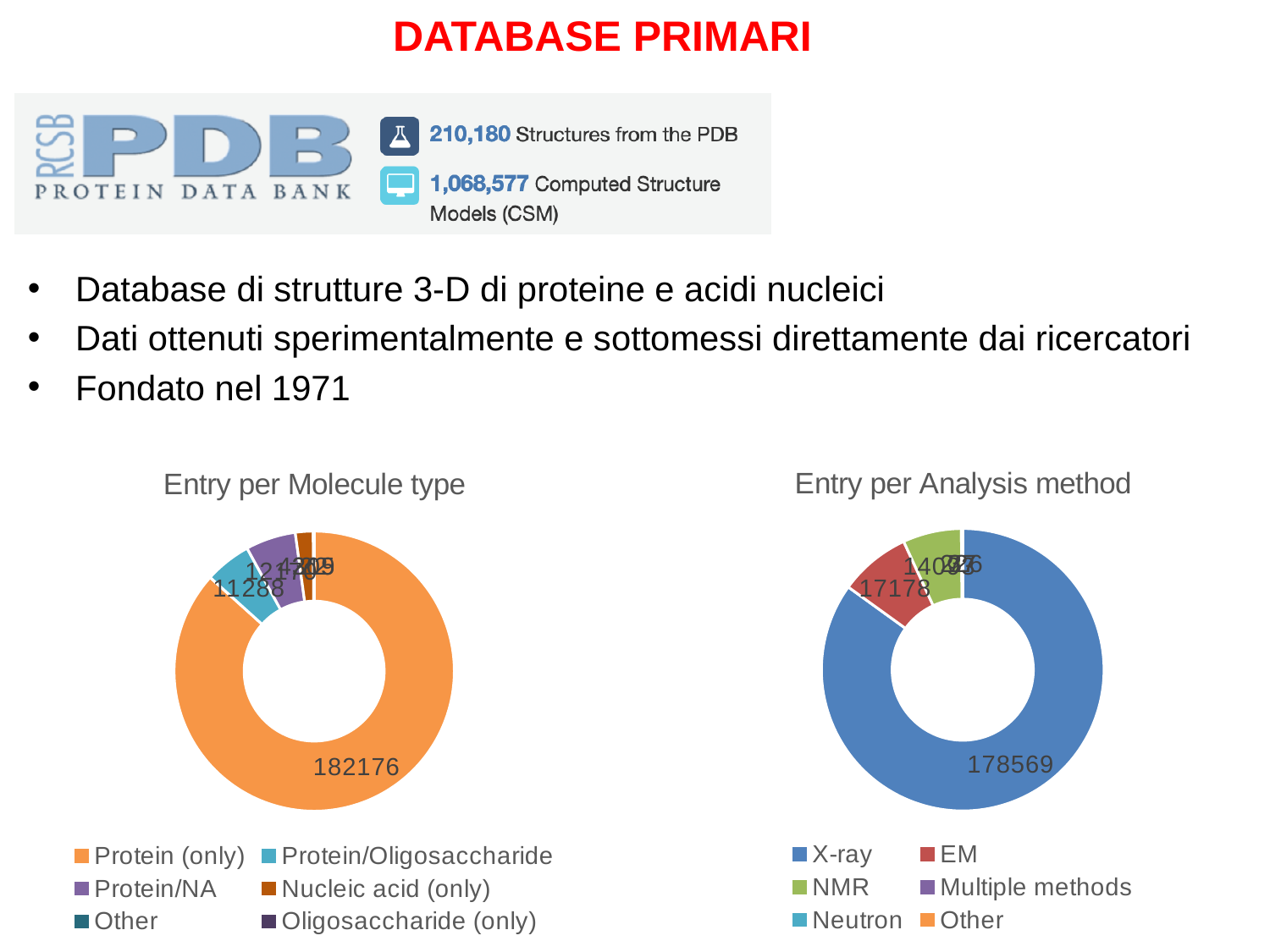
In the 'Entry per Analysis method' chart, what is the value for EM? 17178 In the 'Entry per Analysis method' chart, what colour is the X-ray slice? blue In the 'Entry per Molecule type' chart, what is the value for Protein/Oligosaccharide? 11288 In the 'Entry per Molecule type' chart, which molecule type has the largest slice? Protein (only) In the 'Entry per Molecule type' chart, what kind of chart is shown? doughnut chart In the 'Entry per Analysis method' chart, which analysis method has the largest slice? X-ray In the 'Entry per Molecule type' chart, what is the difference between the Protein (only) and Protein/Oligosaccharide values? 170888 In the 'Entry per Analysis method' chart, what is the difference between the X-ray and EM values? 161391 In the 'Entry per Analysis method' chart, what is the value for X-ray? 178569 In the 'Entry per Analysis method' chart, which is larger, the value for X-ray or the value for EM? X-ray In the 'Entry per Molecule type' chart, what is the value for Protein (only)? 182176 In the 'Entry per Molecule type' chart, how many entries does the legend list? 6